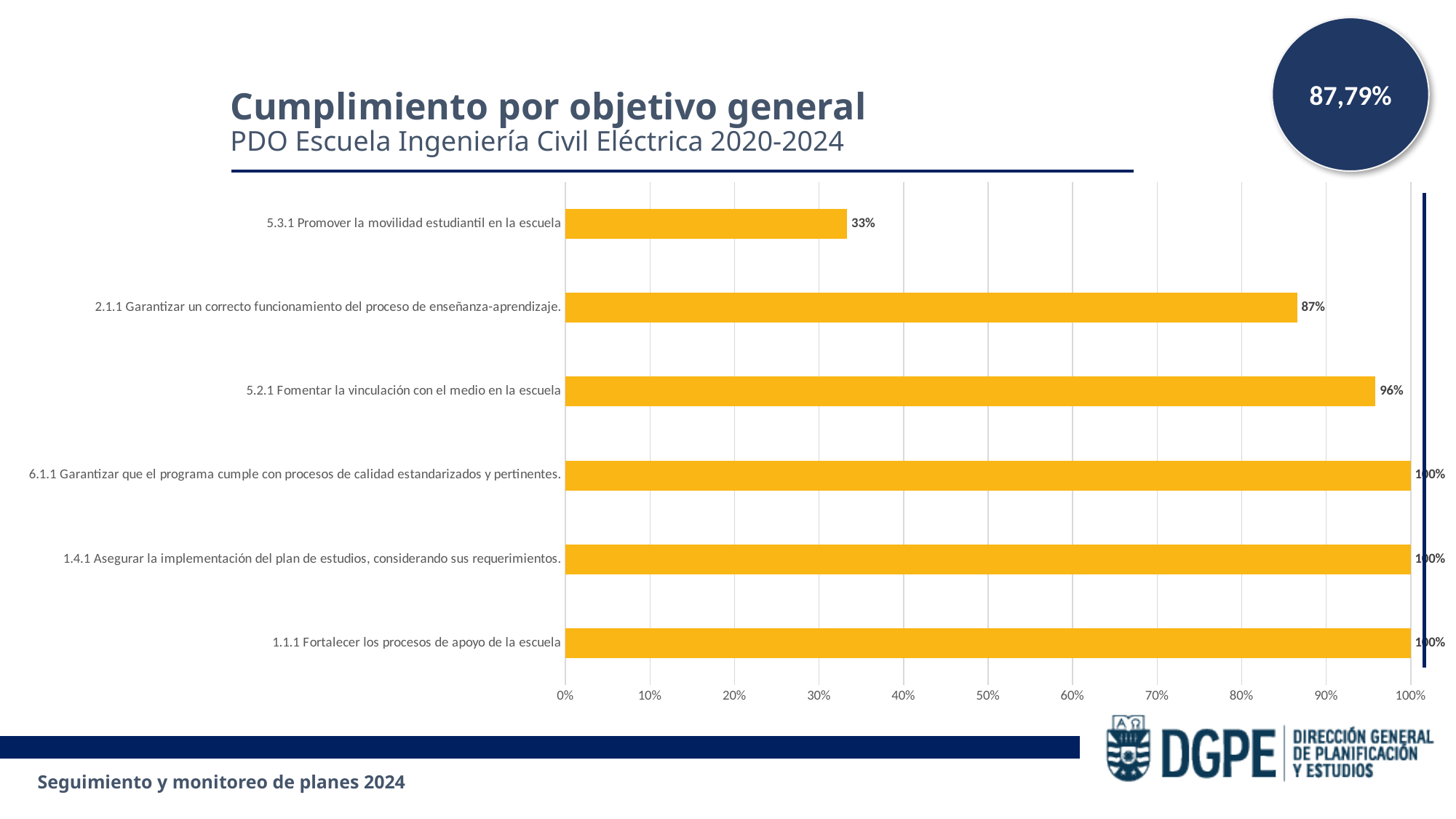
What overall percentage is shown in the circle at the top right of the slide? 87,79% What is the difference between the values for 1.1.1 Fortalecer los procesos de apoyo de la escuela and 5.3.1 Promover la movilidad estudiantil en la escuela? 67% What is the value for 5.2.1 Fomentar la vinculación con el medio en la escuela? 96% What is the value for 5.3.1 Promover la movilidad estudiantil en la escuela? 33% What is the value for 2.1.1 Garantizar un correcto funcionamiento del proceso de enseñanza-aprendizaje? 87% Is the value for 5.3.1 Promover la movilidad estudiantil en la escuela greater or less than 50%? less What kind of chart is shown on the slide? bar chart What is the value for 1.1.1 Fortalecer los procesos de apoyo de la escuela? 100% Which is larger, the value for 2.1.1 Garantizar un correcto funcionamiento del proceso de enseñanza-aprendizaje or the value for 5.2.1 Fomentar la vinculación con el medio en la escuela? 5.2.1 Fomentar la vinculación con el medio en la escuela What is the difference between the values for 5.2.1 Fomentar la vinculación con el medio en la escuela and 2.1.1 Garantizar un correcto funcionamiento del proceso de enseñanza-aprendizaje? 9% Which objective has the lowest value? 5.3.1 Promover la movilidad estudiantil en la escuela How many objectives are shown in the chart? 6